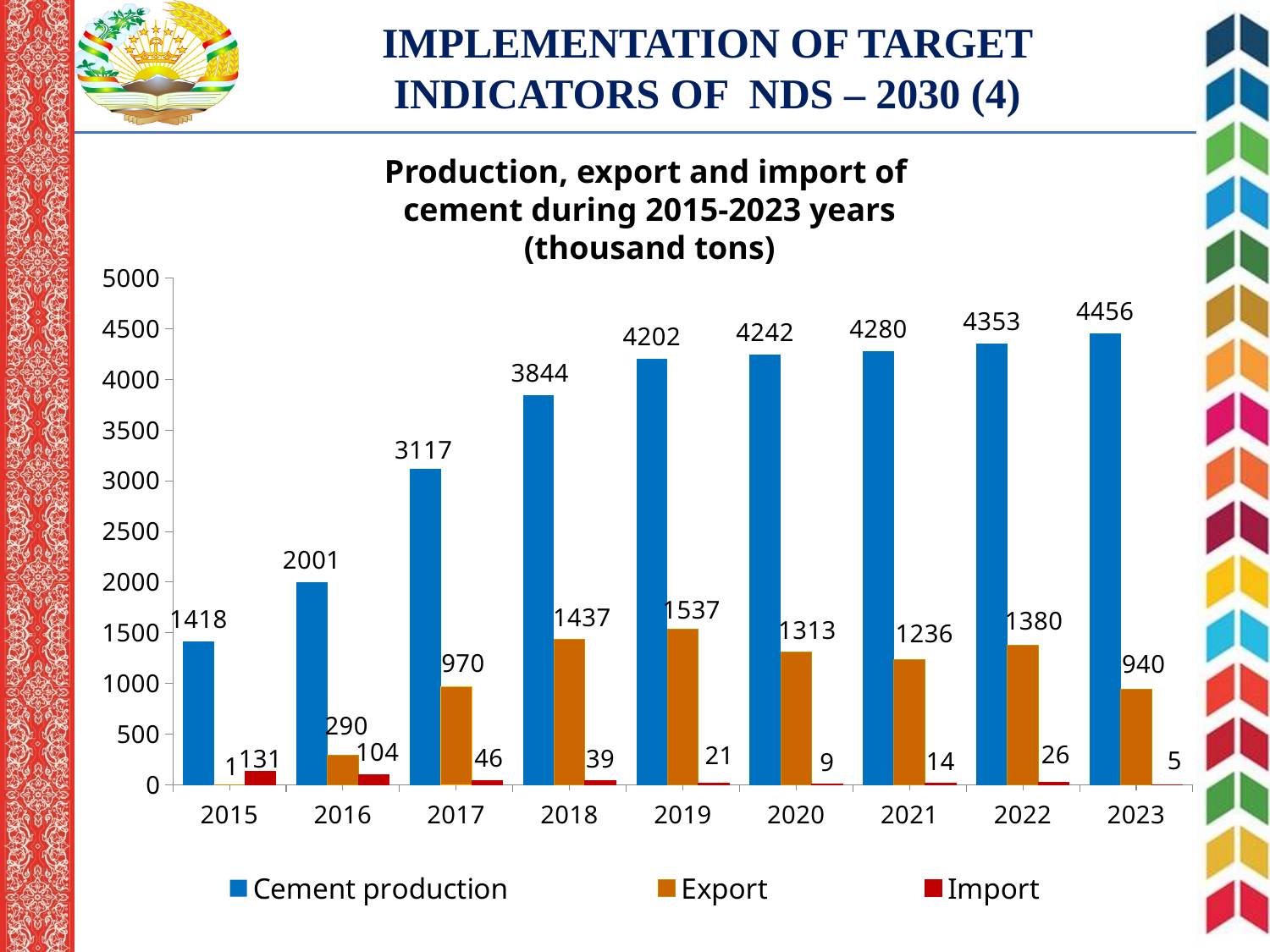
What colour represents Import in the chart? Red What was the import value of cement in 2015? 131 What was the export value of cement in 2019? 1537 In which year was cement production highest? 2023 How many years are shown on the x axis? 9 How many series does the legend list? 3 Does cement production rise or fall from 2015 to 2023? Rise Which was larger in 2022, export or import of cement? Export What was cement production in 2018? 3844 What is the difference between cement production in 2023 and in 2015? 3038 In which year was cement export lowest? 2015 What kind of chart is shown on the slide? Bar chart